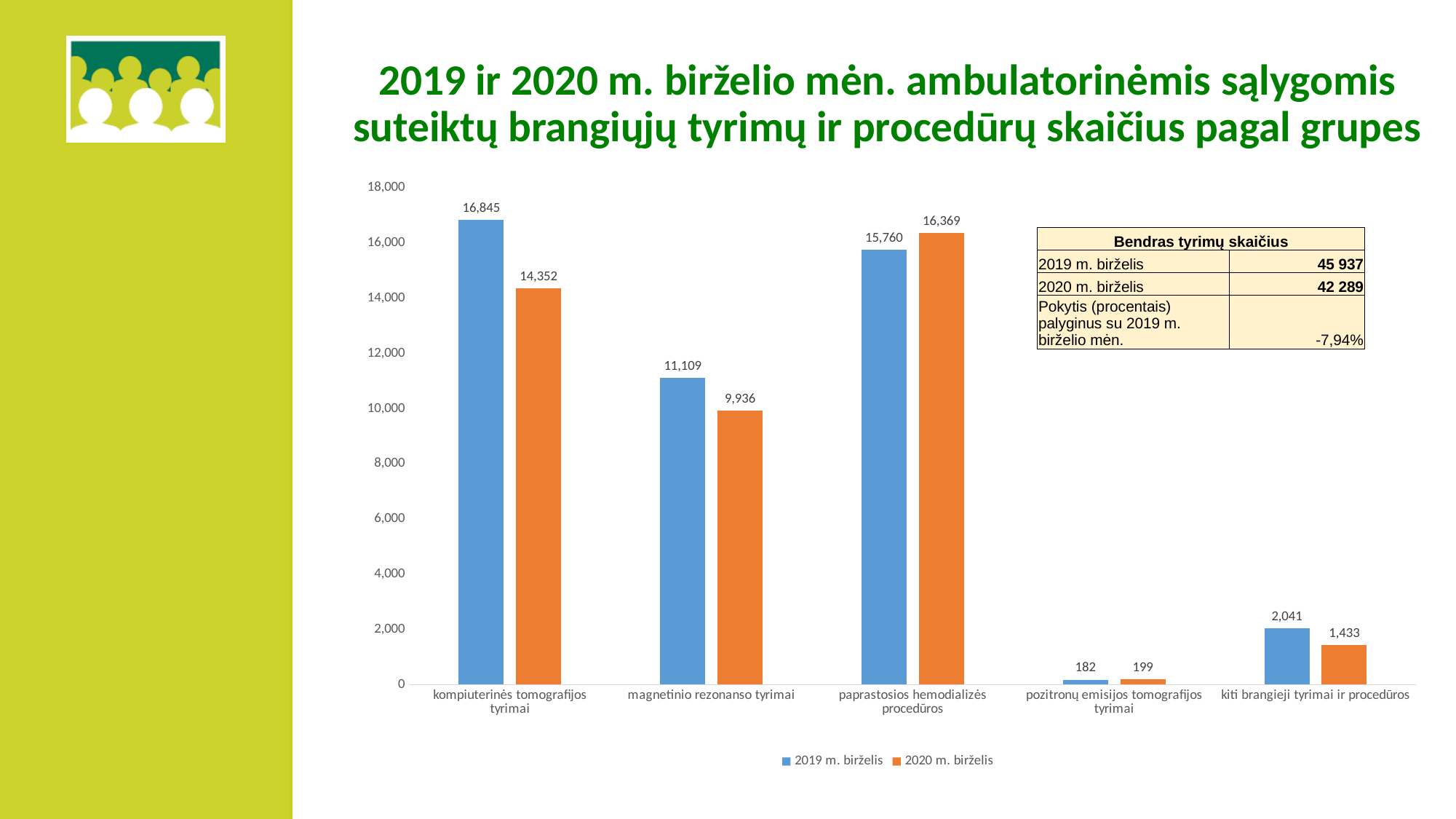
For kiti brangieji tyrimai ir procedūros, which series has the larger value, 2019 m. birželis or 2020 m. birželis? 2019 m. birželis Is the 2020 m. birželis value for magnetinio rezonanso tyrimai greater or less than 10,000? less What is the difference between the 2019 m. birželis and 2020 m. birželis values for magnetinio rezonanso tyrimai? 1,173 Which colour represents the 2020 m. birželis series in the chart? orange Which category has the highest value in the 2019 m. birželis series? kompiuterinės tomografijos tyrimai How many categories are shown on the x axis of the chart? 5 What type of chart is shown on the slide? bar chart Which category has the lowest value in the 2020 m. birželis series? pozitronų emisijos tomografijos tyrimai What is the value for pozitronų emisijos tomografijos tyrimai in the 2019 m. birželis series? 182 What is the value for kompiuterinės tomografijos tyrimai in the 2019 m. birželis series? 16,845 What is the value for paprastosios hemodializės procedūros in the 2020 m. birželis series? 16,369 How many series does the chart legend list? 2